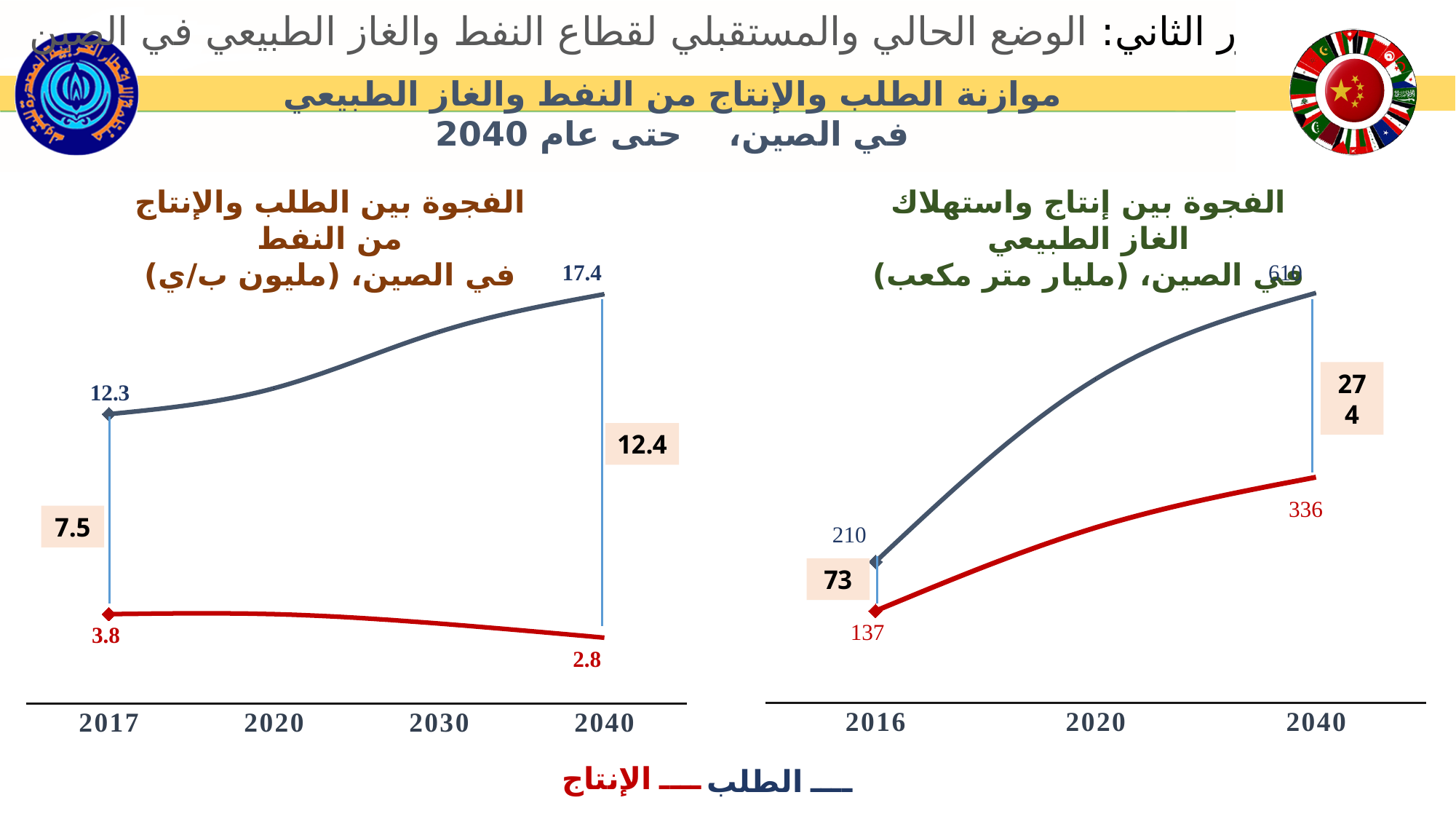
In the left chart (oil, million b/d), what is the production value in 2040? 2.8 In the left chart (oil, million b/d), what is the gap between demand and production shown for 2017? 7.5 In the right chart (natural gas, billion cubic meters), what is the gap between demand and production shown for 2016? 73 In the right chart (natural gas), which is larger in 2016, demand or production? demand In the left chart (oil, million b/d), does the production line rise or fall from 2017 to 2040? fall In the right chart (natural gas, billion cubic meters), what is the production value in 2040? 336 In the left chart (oil, million b/d), what is the demand value in 2040? 17.4 In the left chart (oil, million b/d), by how much does demand increase from 2017 to 2040? 5.1 How many series does the shared legend at the bottom of the slide list? 2 In the left chart (oil, million b/d), what is the demand value in 2017? 12.3 In the right chart (natural gas, billion cubic meters), what is the demand value in 2016? 210 What type of chart is the left chart (oil demand and production gap in China)? line chart